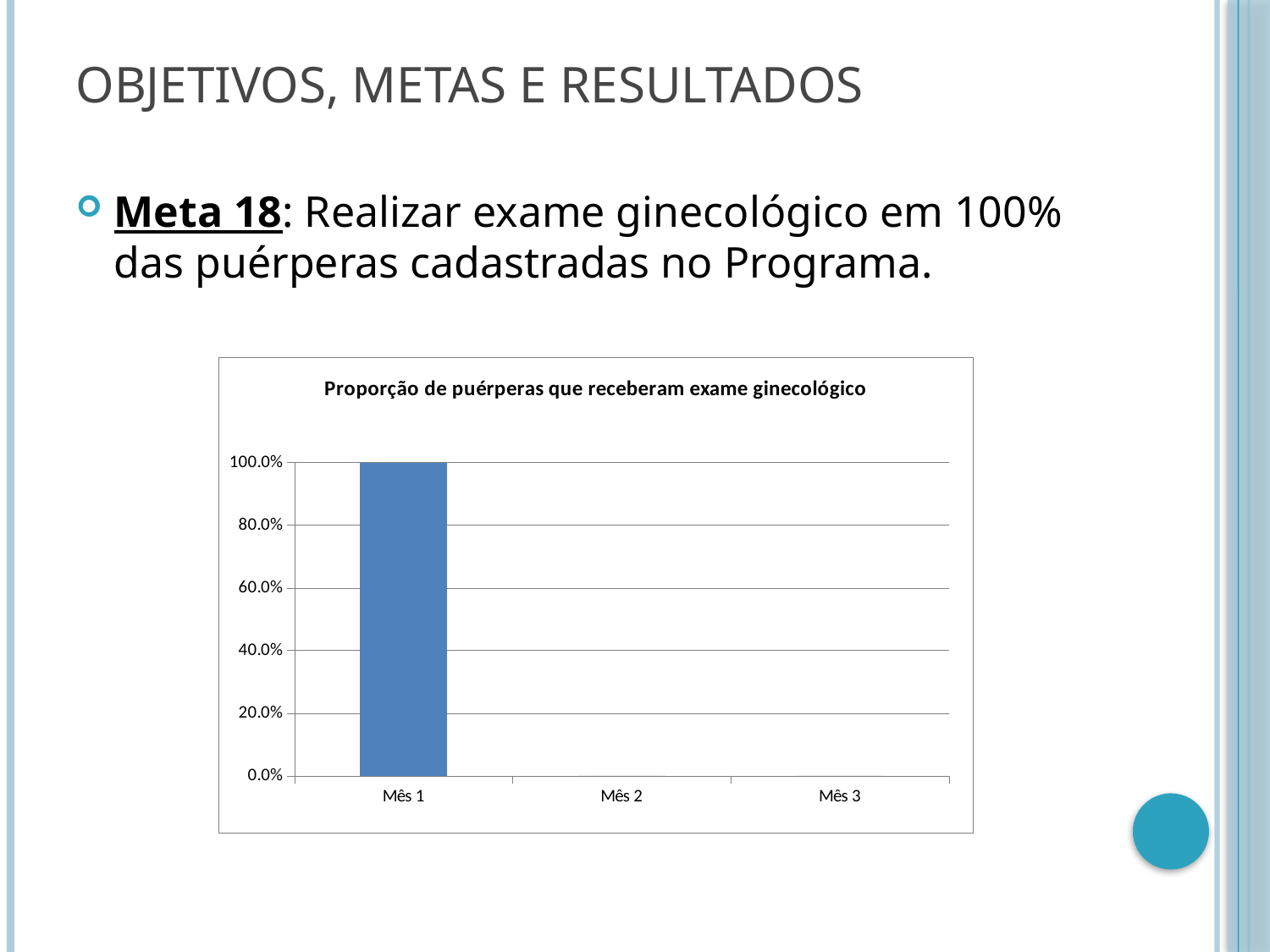
How many categories are shown on the x axis of the chart? 3 What is the title of the chart? Proporção de puérperas que receberam exame ginecológico Which has the larger value, Mês 1 or Mês 3? Mês 1 Which month has the highest value in the chart? Mês 1 Do the values rise or fall from Mês 1 to Mês 3? fall What is the highest value shown on the y axis of the chart? 100.0% Is the value for Mês 1 greater or less than 80.0%? greater What kind of chart is shown on the slide? bar chart Which has the larger value, Mês 1 or Mês 2? Mês 1 What is the value for Mês 1 in the chart? 100.0%